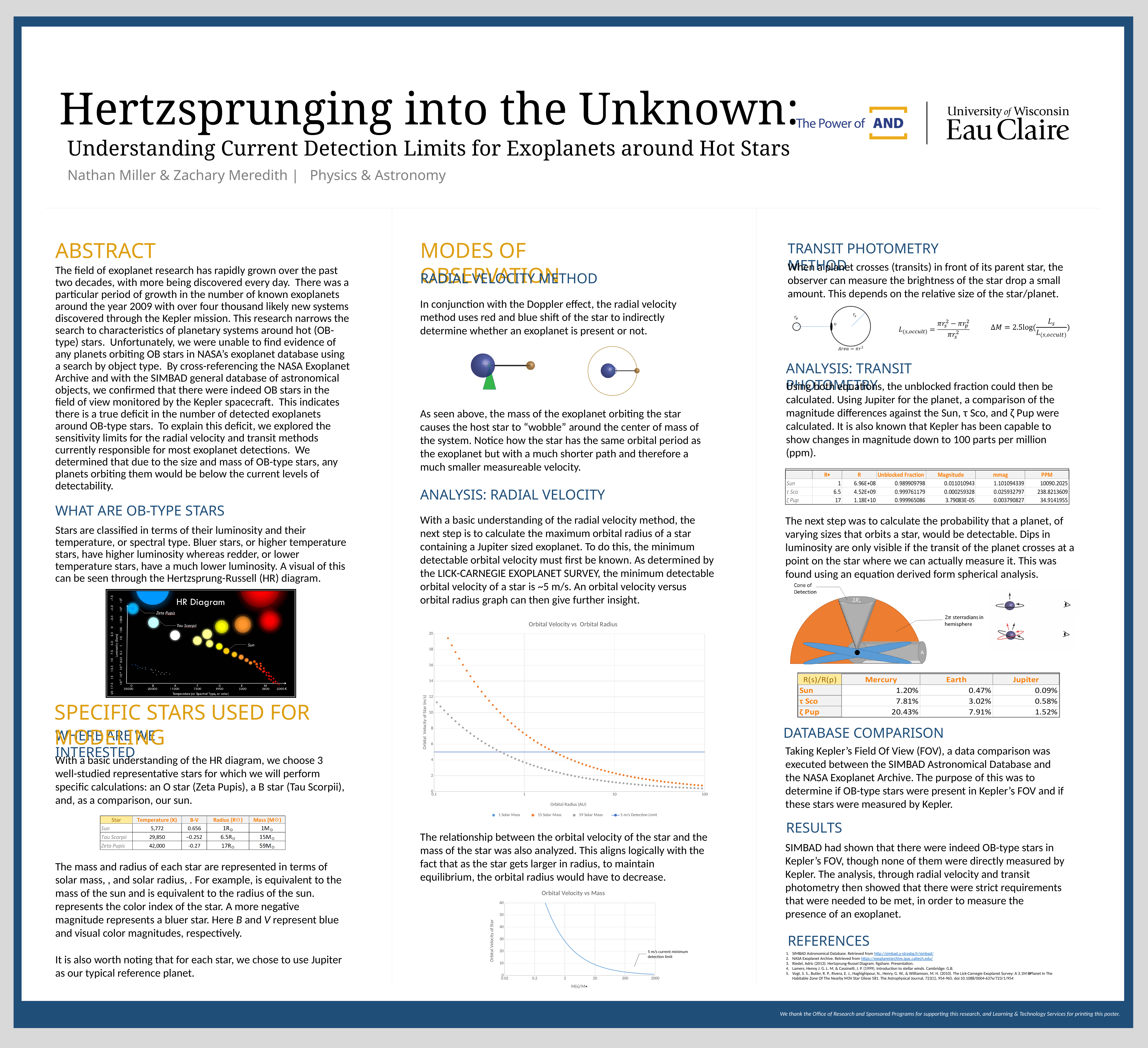
In the 'Orbital Velocity vs Mass' chart, at a mass of 20 on the x axis, is the orbital velocity greater or less than 10? less What kind of chart is 'Orbital Velocity vs Mass'? line chart In the 'Orbital Velocity vs Orbital Radius' chart, what is the highest value shown on the y axis? 20 In the 'Orbital Velocity vs Orbital Radius' chart, at an orbital radius of 10 AU, is the value for the 15 Solar Mass series greater or less than 5? less In the 'Orbital Velocity vs Orbital Radius' chart, at an orbital radius of 1 AU, is the value for the 15 Solar Mass series greater or less than 5? greater In the 'Orbital Velocity vs Orbital Radius' chart, at an orbital radius of 1 AU, which series has the higher orbital velocity: 15 Solar Mass or 59 Solar Mass? 15 Solar Mass In the 'Orbital Velocity vs Orbital Radius' chart, do the plotted orbital velocities rise or fall as orbital radius increases? fall In the 'Orbital Velocity vs Orbital Radius' chart, how many entries does the legend list? 4 What is the title of the upper chart in the middle column? Orbital Velocity vs Orbital Radius In the 'Orbital Velocity vs Mass' chart, does the orbital velocity rise or fall as the mass increases? fall In the 'Orbital Velocity vs Orbital Radius' chart, what is the label of the y axis? Orbital Velocity of Star (m/s)